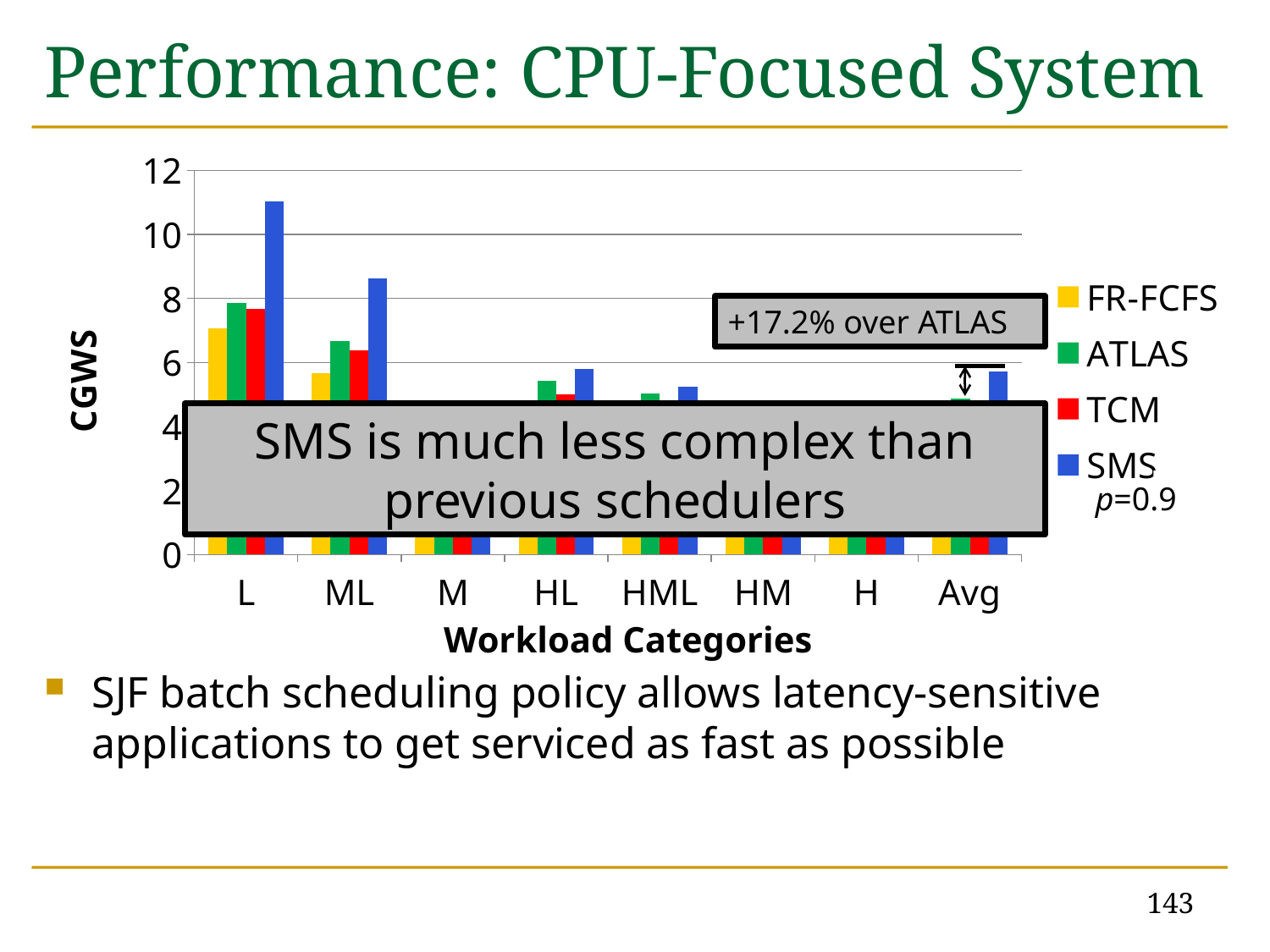
Is the FR-FCFS value for workload category L greater or less than 6? greater Is the SMS value for workload category L greater or less than 10? greater What improvement over ATLAS does the annotation on the chart state? +17.2% over ATLAS What is the label of the y axis? CGWS How many series does the legend list? 4 Is the SMS value for workload category ML greater or less than 8? greater How many workload categories are shown on the x axis? 8 What kind of chart is shown on the slide? bar chart For workload category L, which is larger: the SMS value or the TCM value? SMS Which workload category contains the tallest bar in the chart? L Which series has the highest value for workload category L? SMS For workload category L, which is larger: the ATLAS value or the FR-FCFS value? ATLAS